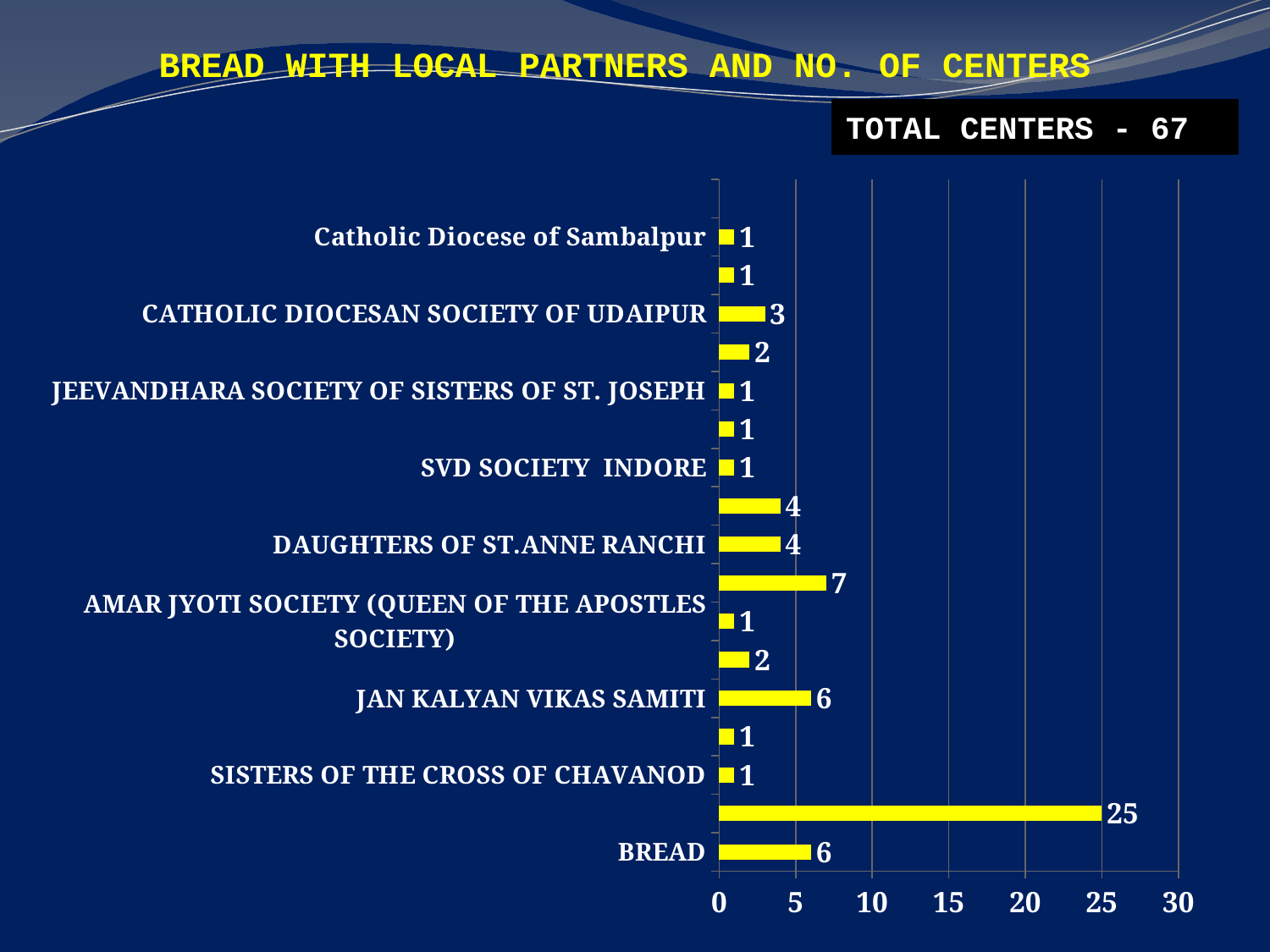
What is the value for JAN KALYAN VIKAS SAMITI? 6 What is the value for BREAD? 6 What is the difference between the values for JAN KALYAN VIKAS SAMITI and DAUGHTERS OF ST.ANNE RANCHI? 2 What total number of centers is stated on the slide? 67 What kind of chart is shown on the slide? bar chart How many bars are plotted in the chart? 17 What is the value for CATHOLIC DIOCESAN SOCIETY OF UDAIPUR? 3 What is the value for DAUGHTERS OF ST.ANNE RANCHI? 4 What is the largest value shown on any bar in the chart? 25 Is the value of the longest bar greater or less than 20? greater What is the value for SVD SOCIETY INDORE? 1 Which has a larger value, CATHOLIC DIOCESAN SOCIETY OF UDAIPUR or Catholic Diocese of Sambalpur? CATHOLIC DIOCESAN SOCIETY OF UDAIPUR